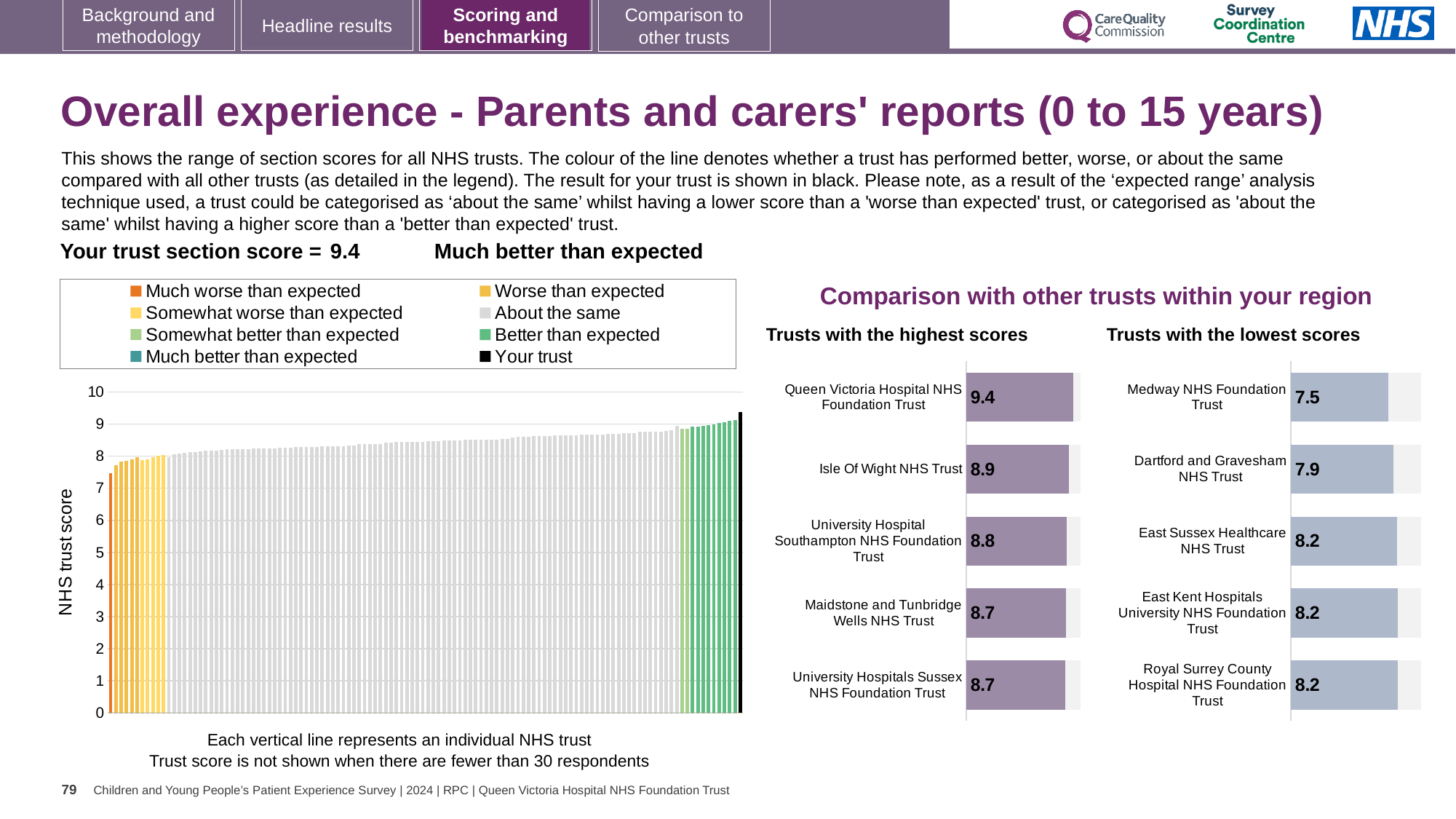
In the 'Trusts with the highest scores' chart, what is the difference between the scores of Queen Victoria Hospital NHS Foundation Trust and Isle Of Wight NHS Trust? 0.5 In the 'Trusts with the highest scores' chart, what is the score for Isle Of Wight NHS Trust? 8.9 In the 'Trusts with the highest scores' chart, which has the higher score: University Hospital Southampton NHS Foundation Trust or Maidstone and Tunbridge Wells NHS Trust? University Hospital Southampton NHS Foundation Trust In the large 'NHS trust score' chart on the left, is the value of the black 'Your trust' bar greater or less than 9? greater In the 'Trusts with the lowest scores' chart, which trust has the lowest score? Medway NHS Foundation Trust In the 'Trusts with the highest scores' chart, which trust has the highest score? Queen Victoria Hospital NHS Foundation Trust How many entries does the legend above the large 'NHS trust score' chart list? 8 In the 'Trusts with the lowest scores' chart, what is the difference between the scores of Dartford and Gravesham NHS Trust and Medway NHS Foundation Trust? 0.4 What kind of chart is the large 'NHS trust score' chart on the left? Bar chart In the 'Trusts with the lowest scores' chart, what is the score for Medway NHS Foundation Trust? 7.5 In the large 'NHS trust score' chart on the left, do the bars rise or fall from left to right? Rise How many trusts are shown in the 'Trusts with the highest scores' chart? 5